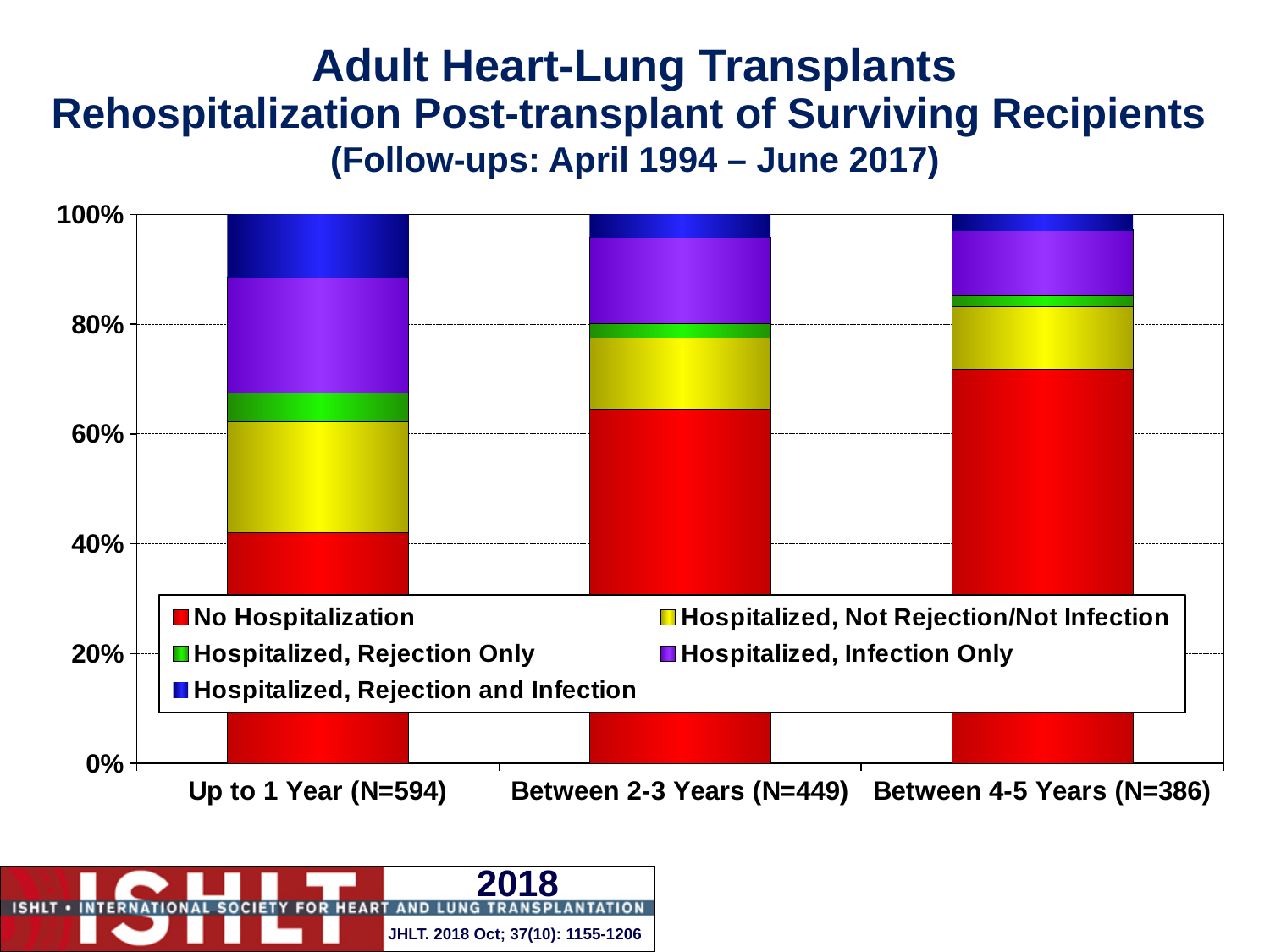
Is the No Hospitalization share for Up to 1 Year (N=594) greater or less than 60%? less What colour represents No Hospitalization in the legend? Red Does the No Hospitalization share rise or fall from Up to 1 Year to Between 4-5 Years? Rise What kind of chart is shown on the slide? Stacked bar chart How many series does the legend list? 5 Which follow-up period has the smallest No Hospitalization share? Up to 1 Year (N=594) How many follow-up period categories are shown on the x axis? 3 Which follow-up period has the largest No Hospitalization share? Between 4-5 Years (N=386) Is the No Hospitalization share larger for Up to 1 Year (N=594) or for Between 2-3 Years (N=449)? Between 2-3 Years (N=449) Is the No Hospitalization share for Up to 1 Year (N=594) greater or less than 20%? greater Is the No Hospitalization share for Between 4-5 Years (N=386) greater or less than 60%? greater